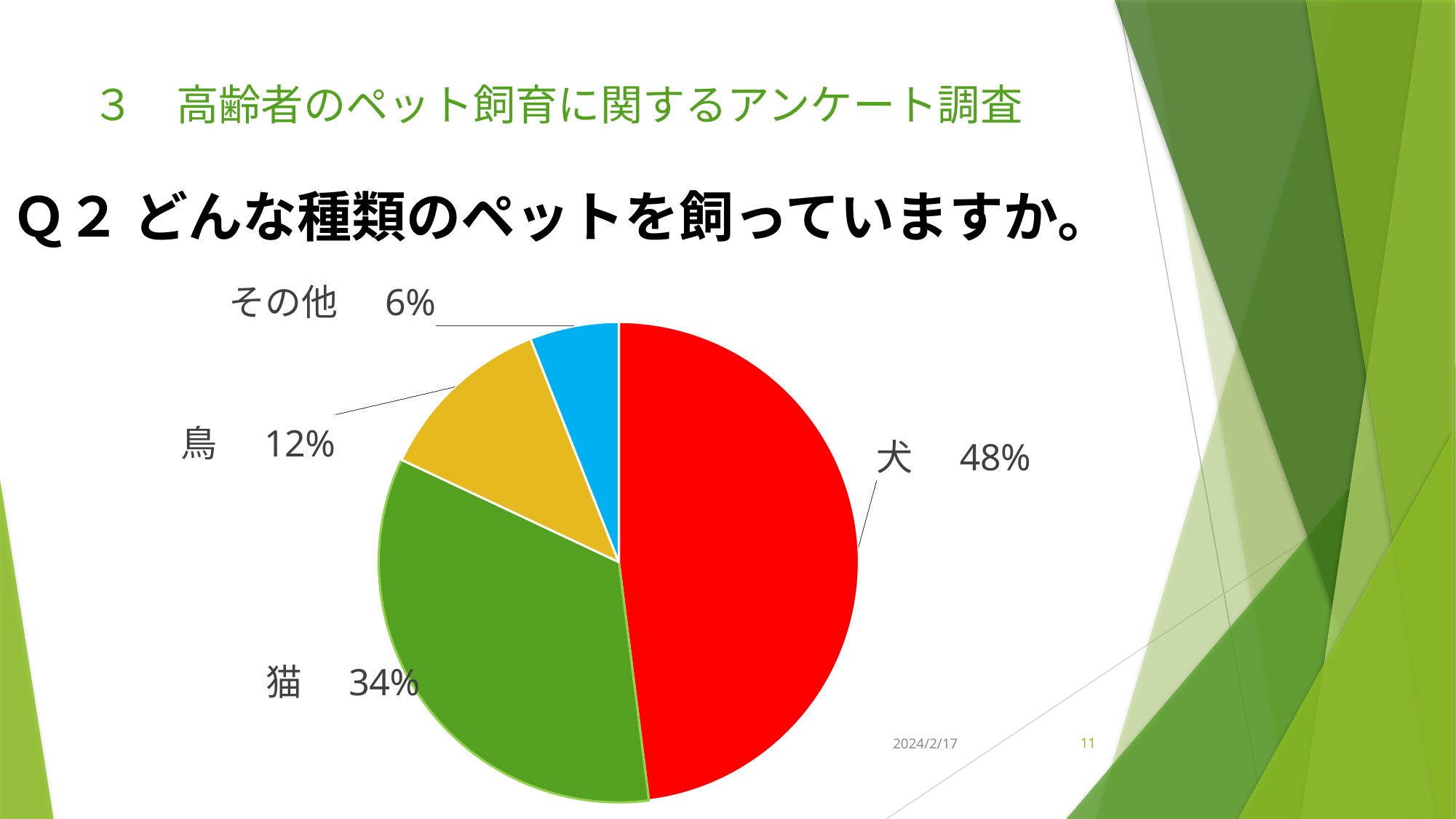
What is the difference in percentage points between 犬 and 猫? 14 What kind of chart is shown on the slide? pie chart How many slices does the pie chart have? 4 Which pet type has the largest share of the pie? 犬 What percentage of respondents keep a bird (鳥)? 12% What percentage of respondents keep a dog (犬)? 48% What is the difference in percentage points between 鳥 and その他? 6 What percentage is shown for その他 (other)? 6% Which pet type has the smallest share of the pie? その他 What percentage of respondents keep a cat (猫)? 34% What colour is the slice for 犬? red Which is larger, the share for 猫 or the share for 鳥? 猫